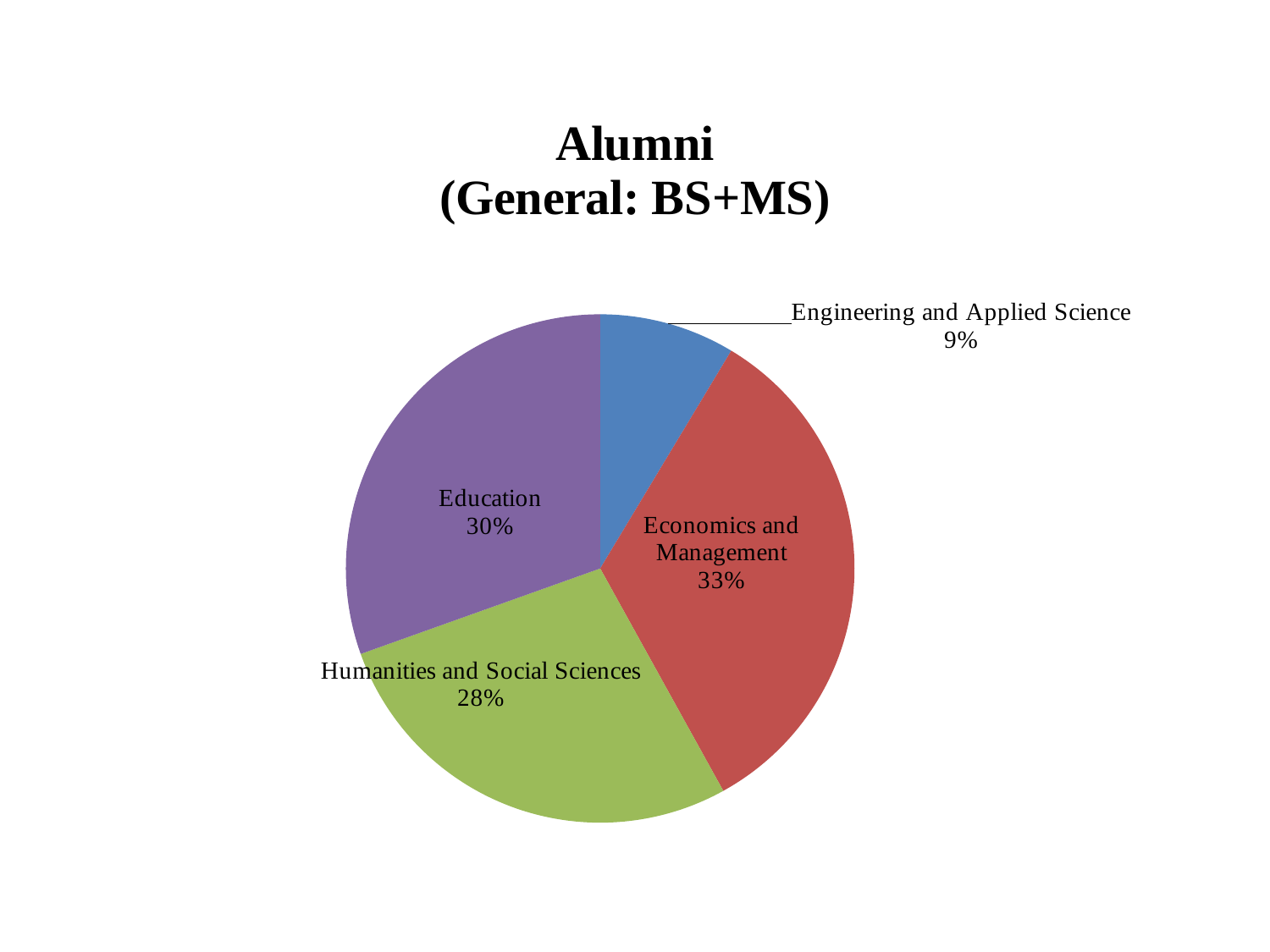
What share of the pie does Education represent? 30% What kind of chart is shown on the slide? Pie chart What percentage is shown for Engineering and Applied Science? 9% What is the difference in percentage points between Economics and Management and Engineering and Applied Science? 24 What percentage is shown for Economics and Management? 33% Which category has the smallest share of the pie? Engineering and Applied Science What is the difference in percentage points between Education and Humanities and Social Sciences? 2 What percentage is shown for Humanities and Social Sciences? 28% How many categories are shown in the pie chart? 4 Which is larger, the share for Education or the share for Engineering and Applied Science? Education What is the title of the chart? Alumni (General: BS+MS) Which category has the largest share of the pie? Economics and Management